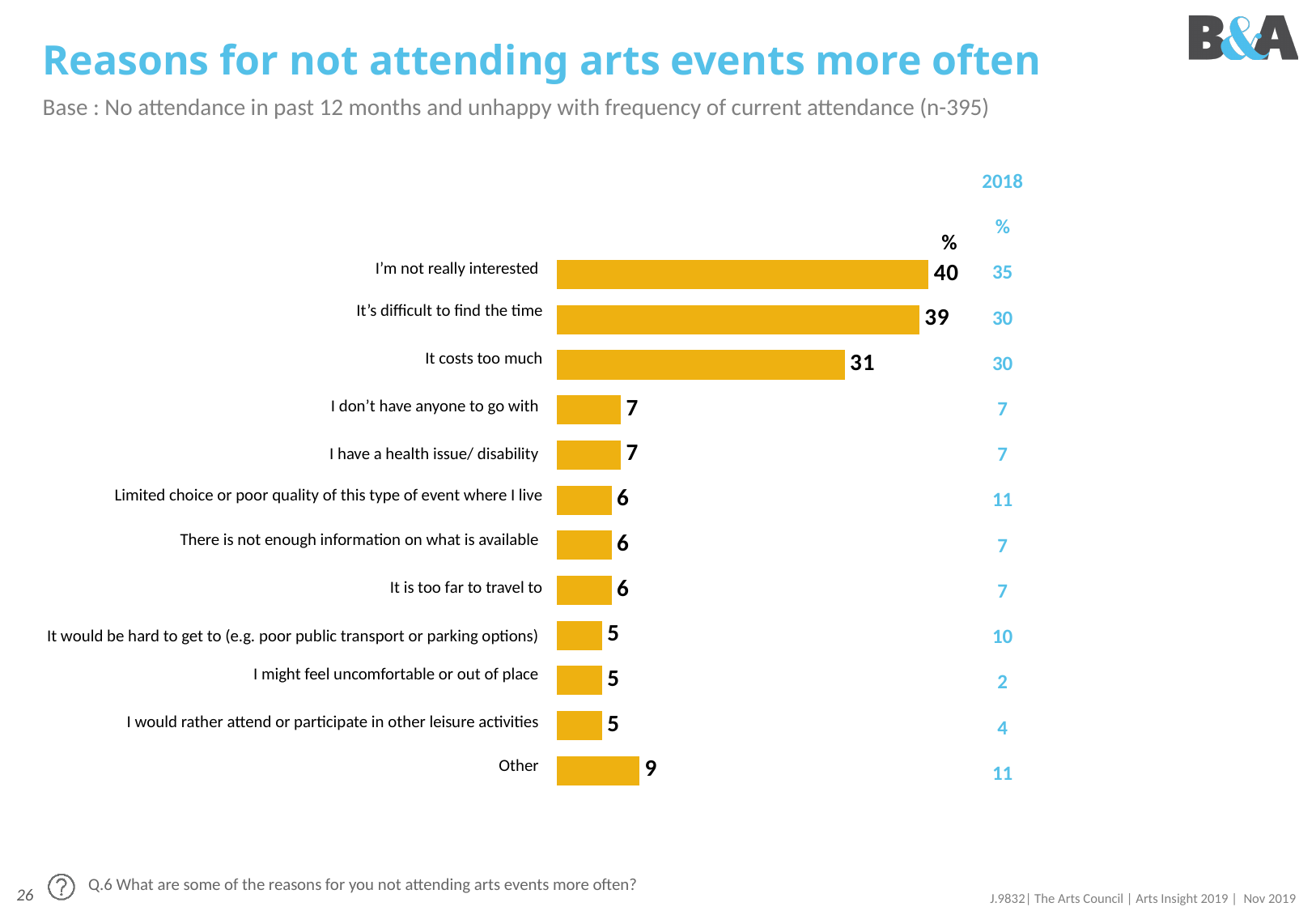
What is the value for "I'm not really interested"? 40 What is the value for "Other"? 9 What type of chart is shown on the slide? Bar chart What is the 2018 value shown next to the chart for "Limited choice or poor quality of this type of event where I live"? 11 What is the value for "I might feel uncomfortable or out of place"? 5 What colour are the bars in the chart? Yellow/orange How many reasons (categories) are plotted in the chart? 12 What is the difference between the value for "I'm not really interested" and the value for "Other"? 31 What is the difference between the values for "It's difficult to find the time" and "It costs too much"? 8 Which is larger: the value for "I don't have anyone to go with" or the value for "It is too far to travel to"? I don't have anyone to go with What is the value for "It costs too much"? 31 Which reason has the highest value in the chart? I'm not really interested